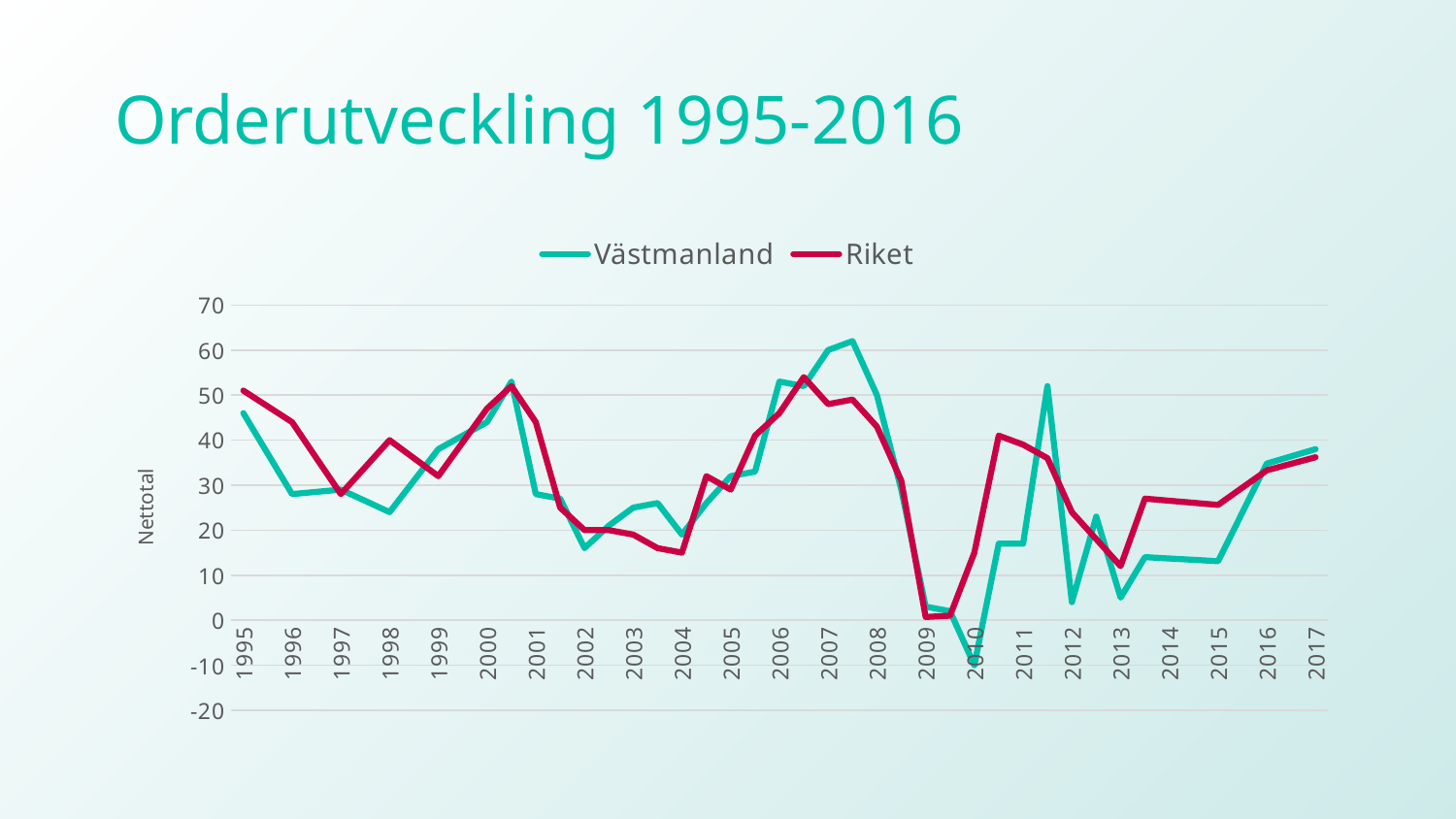
Is the value for Västmanland in 2013 greater or less than 10? less What is the label on the vertical axis? Nettotal Is the value for Riket in 2004 greater or less than 20? less What kind of chart is shown on the slide? line chart Is the value for Riket in 2017 greater or less than 30? greater In 2007, which series has the higher value, Västmanland or Riket? Västmanland What is the title of the chart? Orderutveckling 1995-2016 How many year labels are shown on the x axis? 23 In 1996, which series has the higher value, Västmanland or Riket? Riket How many series does the legend list? 2